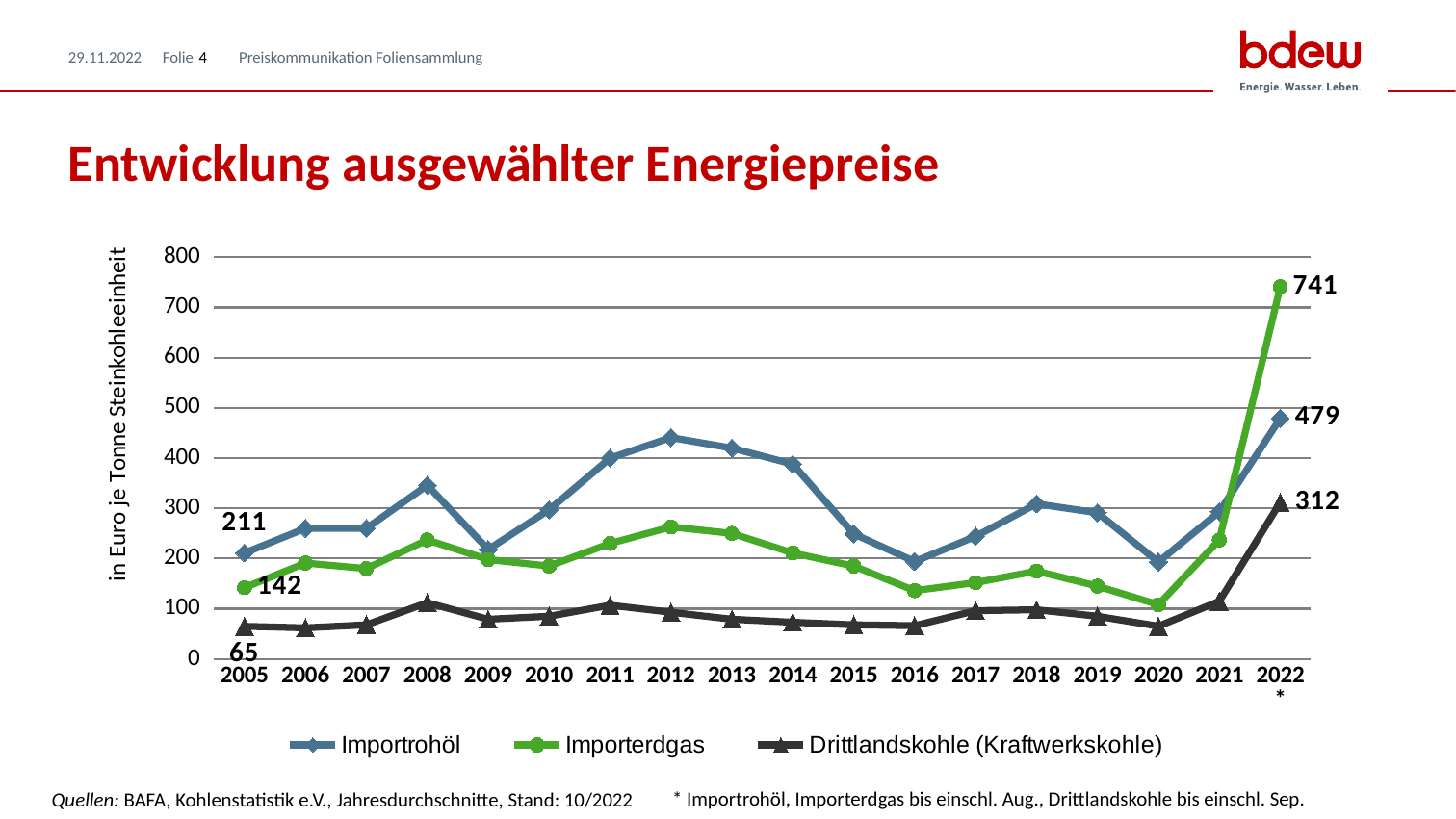
How many years are shown on the x axis? 18 Which series has the highest value in 2022? Importerdgas Is the value for Importrohöl in 2012 greater or less than 400? greater What is the value for Importerdgas in 2022? 741 What is the difference between the Importerdgas value in 2022 and in 2005? 599 What is the value for Drittlandskohle (Kraftwerkskohle) in 2005? 65 How many series does the legend list? 3 What is the difference between the Importrohöl and Drittlandskohle (Kraftwerkskohle) values in 2022? 167 Which series has the lowest value in 2005? Drittlandskohle (Kraftwerkskohle) What is the value for Importrohöl in 2005? 211 What kind of chart is shown on the slide? Line chart What is the value for Importrohöl in 2022? 479